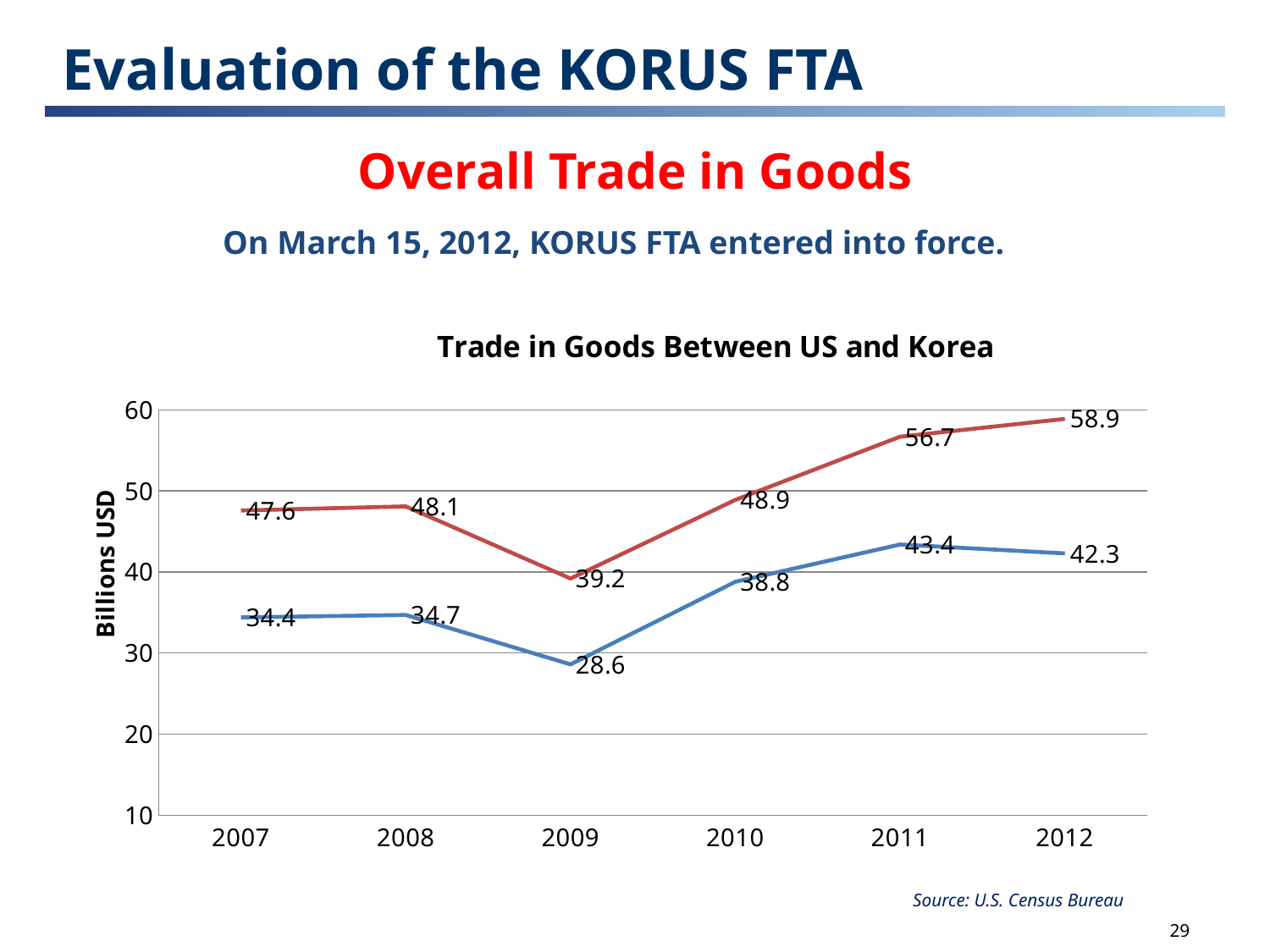
What is the difference between the red line and the blue line in 2011? 13.3 How many years are shown on the x axis? 6 What is the value of the red line in 2010? 48.9 What type of chart is shown on the slide? line chart What is the title of the chart? Trade in Goods Between US and Korea In which year does the red line reach its lowest value? 2009 In which year does the blue line reach its highest value? 2011 What is the value of the red line in 2012? 58.9 What is the value of the blue line in 2009? 28.6 What is the label of the vertical axis? Billions USD Which is larger, the blue line's value in 2008 or its value in 2010? 2010 Does the red line rise or fall between 2009 and 2012? rise